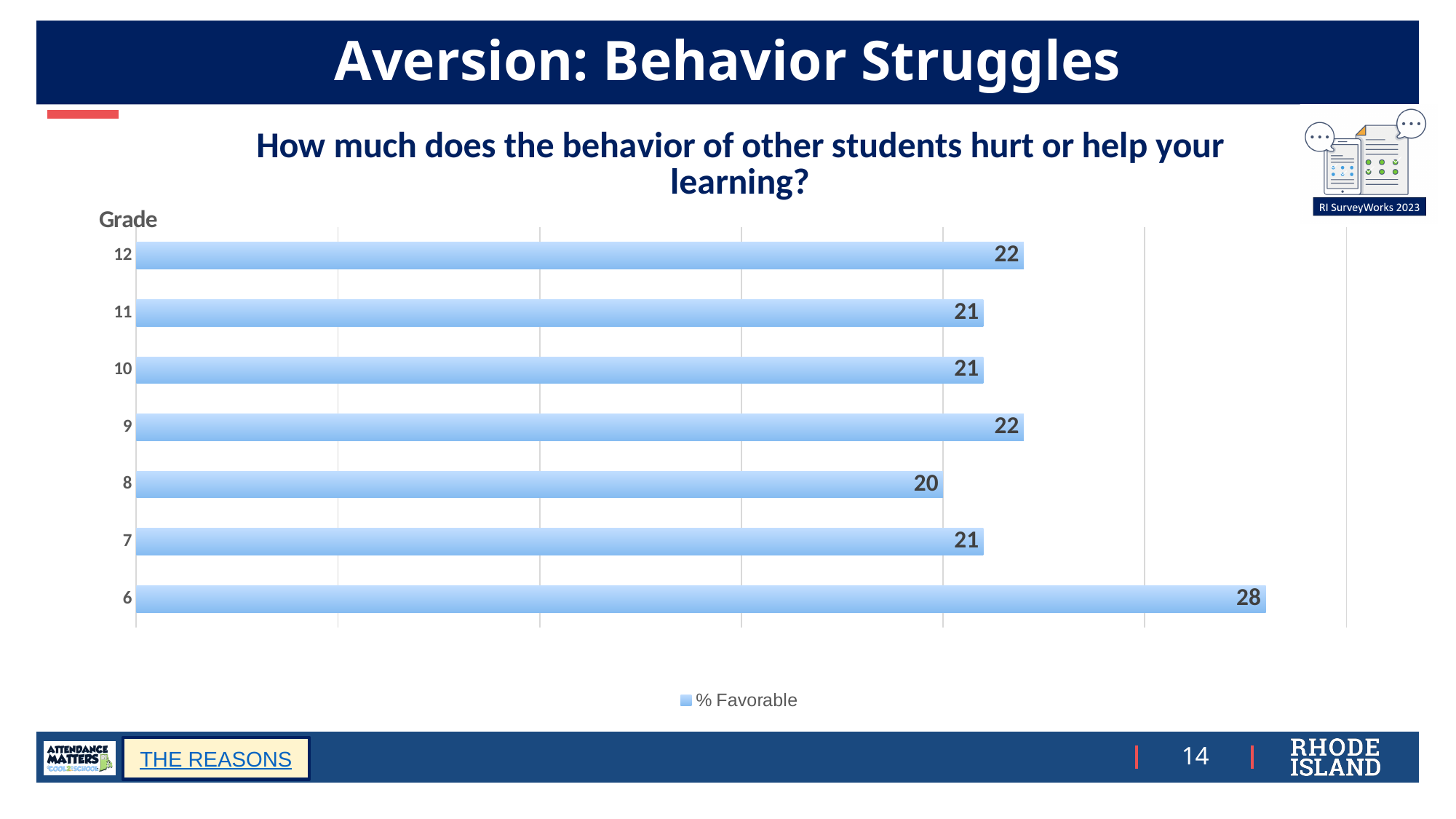
What is the % Favorable value for grade 8? 20 What is the % Favorable value for grade 12? 22 Which grade has the lowest % Favorable value? 8 What is the % Favorable value for grade 6? 28 Which has a larger % Favorable value, grade 6 or grade 9? Grade 6 What kind of chart is shown on the slide? Bar chart What is the difference between the % Favorable values for grade 6 and grade 8? 8 How many series does the legend list? 1 Which grade has the highest % Favorable value? 6 What is the % Favorable value for grade 10? 21 How many grades are shown in the chart? 7 What is the name of the series shown in the legend? % Favorable